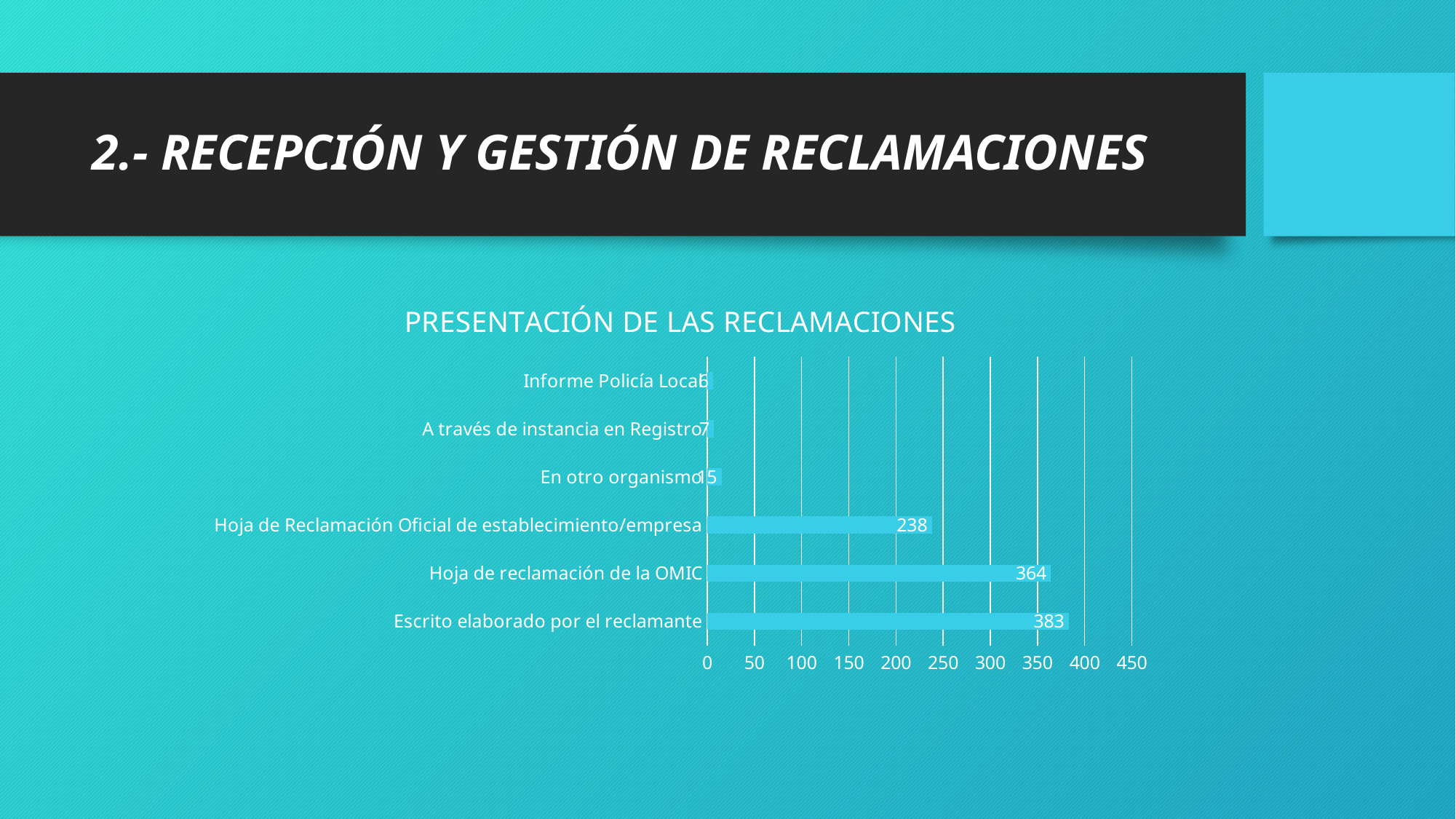
What is the value for En otro organismo? 15 What is the difference between Escrito elaborado por el reclamante and Hoja de reclamación de la OMIC? 19 What is the value for A través de instancia en Registro? 7 What is the value for Hoja de reclamación de la OMIC? 364 What is the value for Hoja de Reclamación Oficial de establecimiento/empresa? 238 What is the difference between Hoja de reclamación de la OMIC and Hoja de Reclamación Oficial de establecimiento/empresa? 126 How many categories are shown in the chart? 6 Which is larger, Hoja de Reclamación Oficial de establecimiento/empresa or En otro organismo? Hoja de Reclamación Oficial de establecimiento/empresa Which category has the highest value? Escrito elaborado por el reclamante Is the value for Hoja de reclamación de la OMIC greater or less than 300? greater What type of chart is shown on the slide? Bar chart What is the value for Escrito elaborado por el reclamante? 383